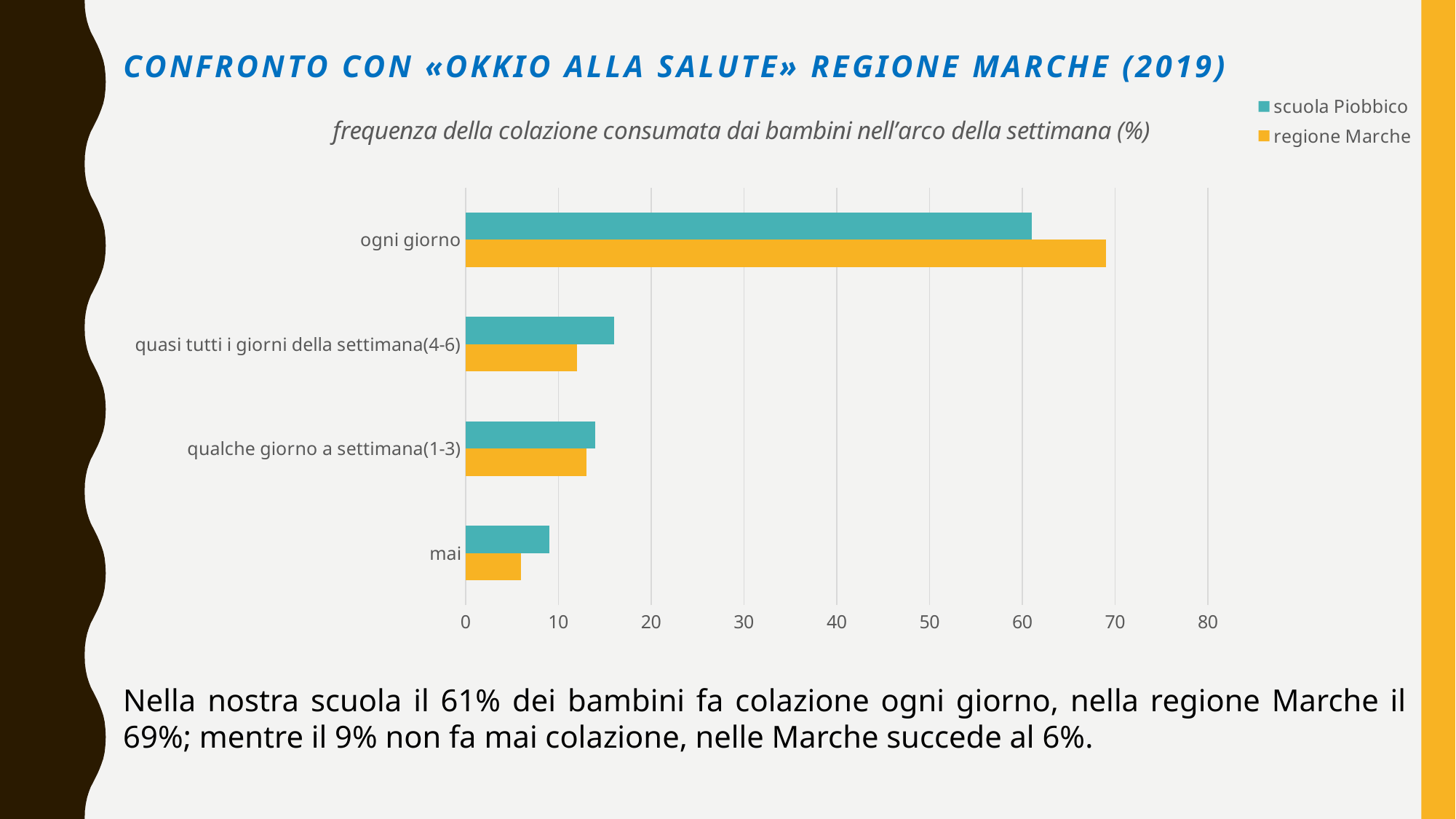
What is the difference between regione Marche and scuola Piobbico in the 'ogni giorno' category? 8% How many series does the chart legend list? 2 Which category has the lowest value for scuola Piobbico? mai What is the value for regione Marche in the 'mai' category? 6% What is the value for regione Marche in the 'ogni giorno' category? 69% Which category has the highest value for regione Marche? ogni giorno Which series is shown in orange in the legend? regione Marche What kind of chart is shown on the slide? bar chart Is the value for scuola Piobbico in 'quasi tutti i giorni della settimana(4-6)' greater or less than 20? less What is the value for scuola Piobbico in the 'mai' category? 9% What is the value for scuola Piobbico in the 'ogni giorno' category? 61% How many categories are shown on the chart? 4